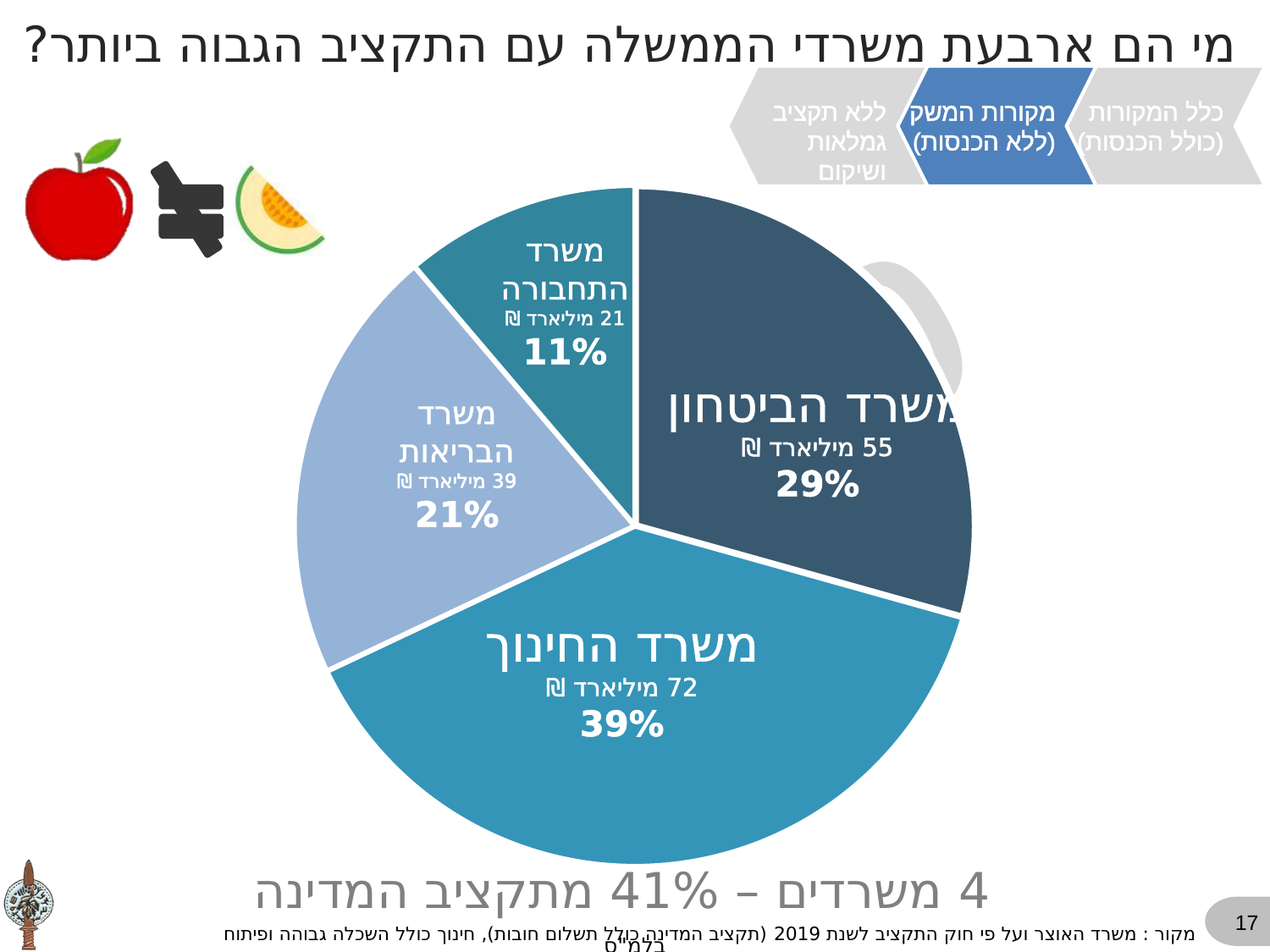
What is the budget value shown for משרד הביטחון? 55 מיליארד ₪ Which ministry has the smallest slice of the pie? משרד התחבורה How many slices does the pie chart have? 4 What is the budget value shown for משרד הבריאות? 39 מיליארד ₪ What is the difference in billions of ₪ between משרד החינוך and משרד הביטחון? 17 מיליארד ₪ What is the title of the slide containing the pie chart? מי הם ארבעת משרדי הממשלה עם התקציב הגבוה ביותר? What kind of chart is shown on the slide? pie chart What percentage of the pie is משרד הביטחון? 29% What percentage of the pie is משרד התחבורה? 11% What percentage of the pie is משרד החינוך? 39% Which ministry has the largest slice of the pie? משרד החינוך Which has a larger budget, משרד הבריאות or משרד התחבורה? משרד הבריאות